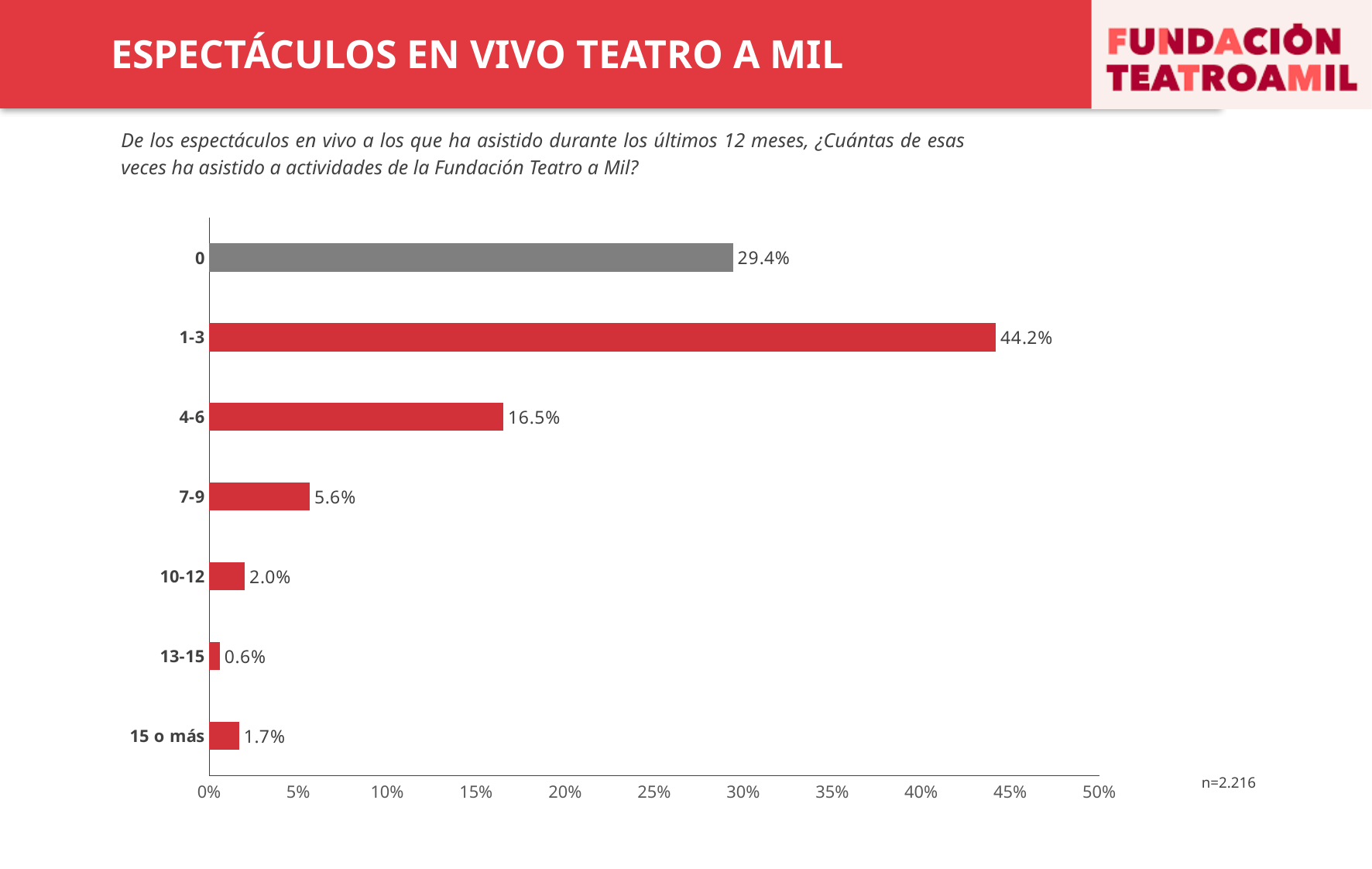
What kind of chart is shown on the slide? Bar chart Is the value for "4-6" greater or less than 15%? greater Which category has the lowest value? 13-15 What is the value for the "4-6" category? 16.5% What is the difference between the values for "1-3" and "0"? 14.8% What is the value for the "1-3" category? 44.2% What is the value for the "15 o más" category? 1.7% Which category has the highest value? 1-3 What is the value for the "0" category? 29.4% How many categories are shown in the chart? 7 Which bar is coloured grey rather than red? 0 Which is larger, the value for "7-9" or the value for "10-12"? 7-9